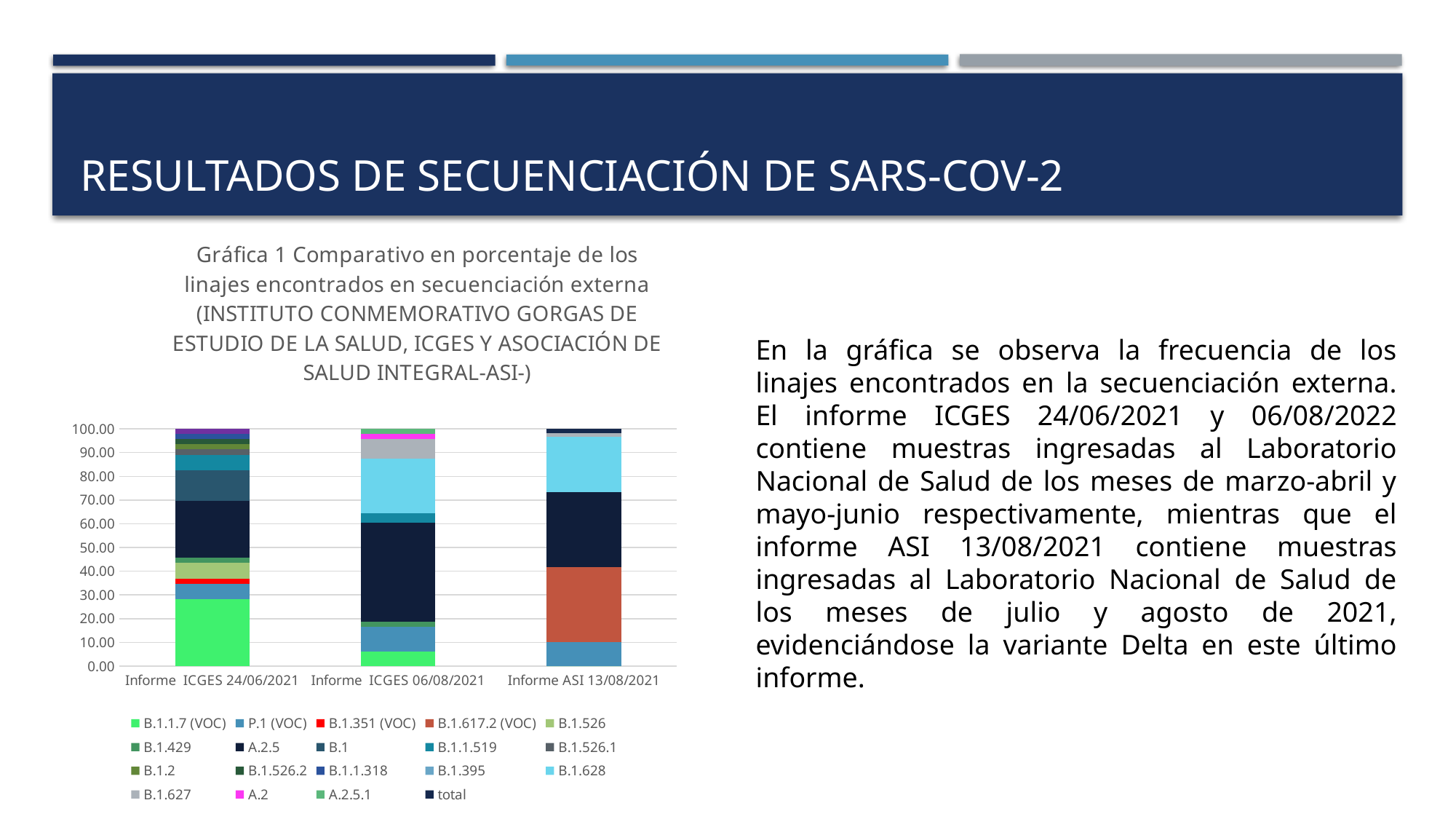
How many categories (informes) are shown on the x axis of the chart? 3 What is the highest value shown on the chart's y axis? 100.00 Is the value of B.1.1.7 (VOC) for Informe ICGES 24/06/2021 greater or less than 40? less Is the value of B.1.628 for Informe ASI 13/08/2021 greater or less than 10? greater Is the value of B.1.617.2 (VOC) for Informe ASI 13/08/2021 greater or less than 20? greater What is the label of the first category on the x axis of the chart? Informe ICGES 24/06/2021 Is the B.1.1.7 (VOC) segment larger in Informe ICGES 24/06/2021 or in Informe ICGES 06/08/2021? Informe ICGES 24/06/2021 Which category has the largest B.1.1.7 (VOC) segment? Informe ICGES 24/06/2021 Which category on the x axis is the only one with a B.1.617.2 (VOC) segment? Informe ASI 13/08/2021 How many series does the chart's legend list? 19 What kind of chart is shown on the slide? Stacked bar chart